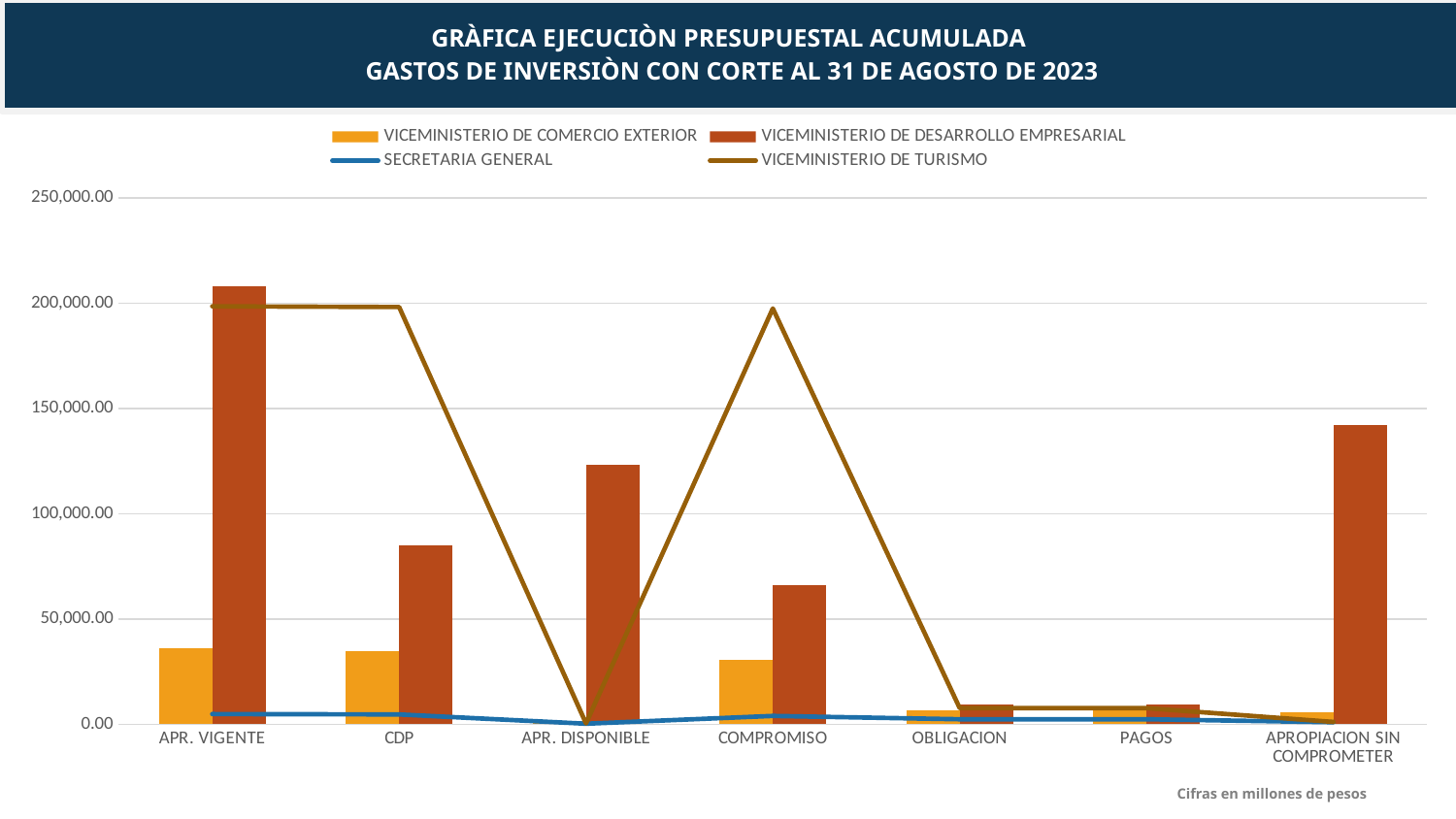
How many series does the legend list? 4 How many categories are shown along the x axis? 7 Does the VICEMINISTERIO DE TURISMO line rise or fall from CDP to APR. DISPONIBLE? fall Is the VICEMINISTERIO DE DESARROLLO EMPRESARIAL value for CDP greater or less than 100,000.00? less For which category is the VICEMINISTERIO DE COMERCIO EXTERIOR bar lowest? APR. DISPONIBLE What kind of chart is shown on the slide? A combined bar and line chart At CDP, which is larger: VICEMINISTERIO DE COMERCIO EXTERIOR or VICEMINISTERIO DE DESARROLLO EMPRESARIAL? VICEMINISTERIO DE DESARROLLO EMPRESARIAL Is the VICEMINISTERIO DE COMERCIO EXTERIOR value for APR. VIGENTE greater or less than 50,000.00? less Is the VICEMINISTERIO DE DESARROLLO EMPRESARIAL value for APROPIACION SIN COMPROMETER greater or less than 150,000.00? less According to the note below the chart, in what units are the figures expressed? Millones de pesos For which category is the VICEMINISTERIO DE DESARROLLO EMPRESARIAL bar highest? APR. VIGENTE